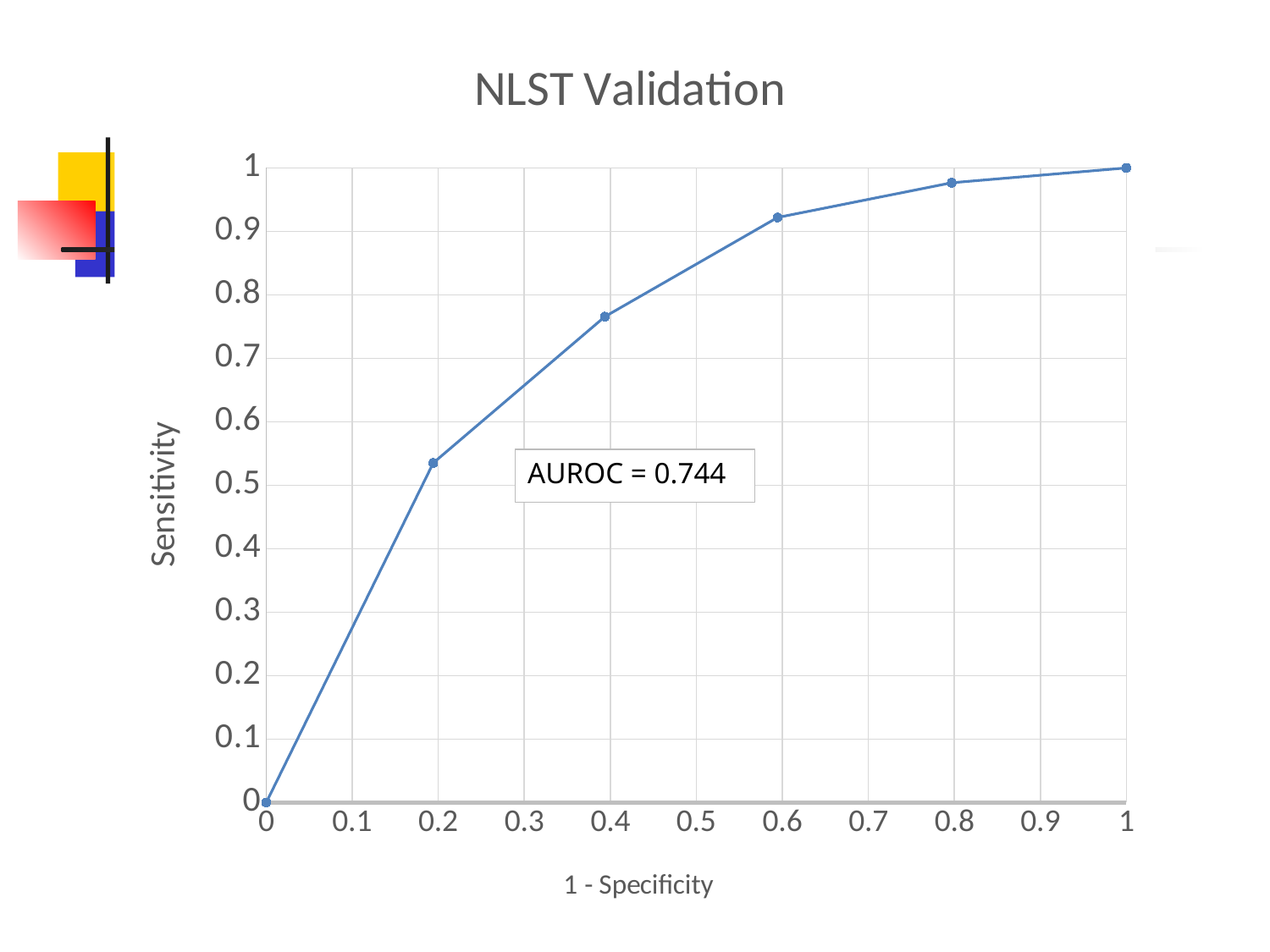
What kind of chart is shown on the slide? line chart Which is larger: the sensitivity at 1 - Specificity near 0.2 or near 0.4? near 0.4 What AUROC value is printed on the chart? 0.744 Does sensitivity rise or fall as 1 - Specificity increases along the x axis? rise Is the sensitivity at the point near 1 - Specificity = 0.2 greater or less than 0.5? greater What is the title of the chart? NLST Validation Is the sensitivity at the point near 1 - Specificity = 0.6 greater or less than 0.9? greater Is the sensitivity at the point near 1 - Specificity = 0.8 greater or less than 0.9? greater How many data points are plotted on the curve? 6 What is the label of the y axis? Sensitivity What is the sensitivity value at 1 - Specificity = 1? 1